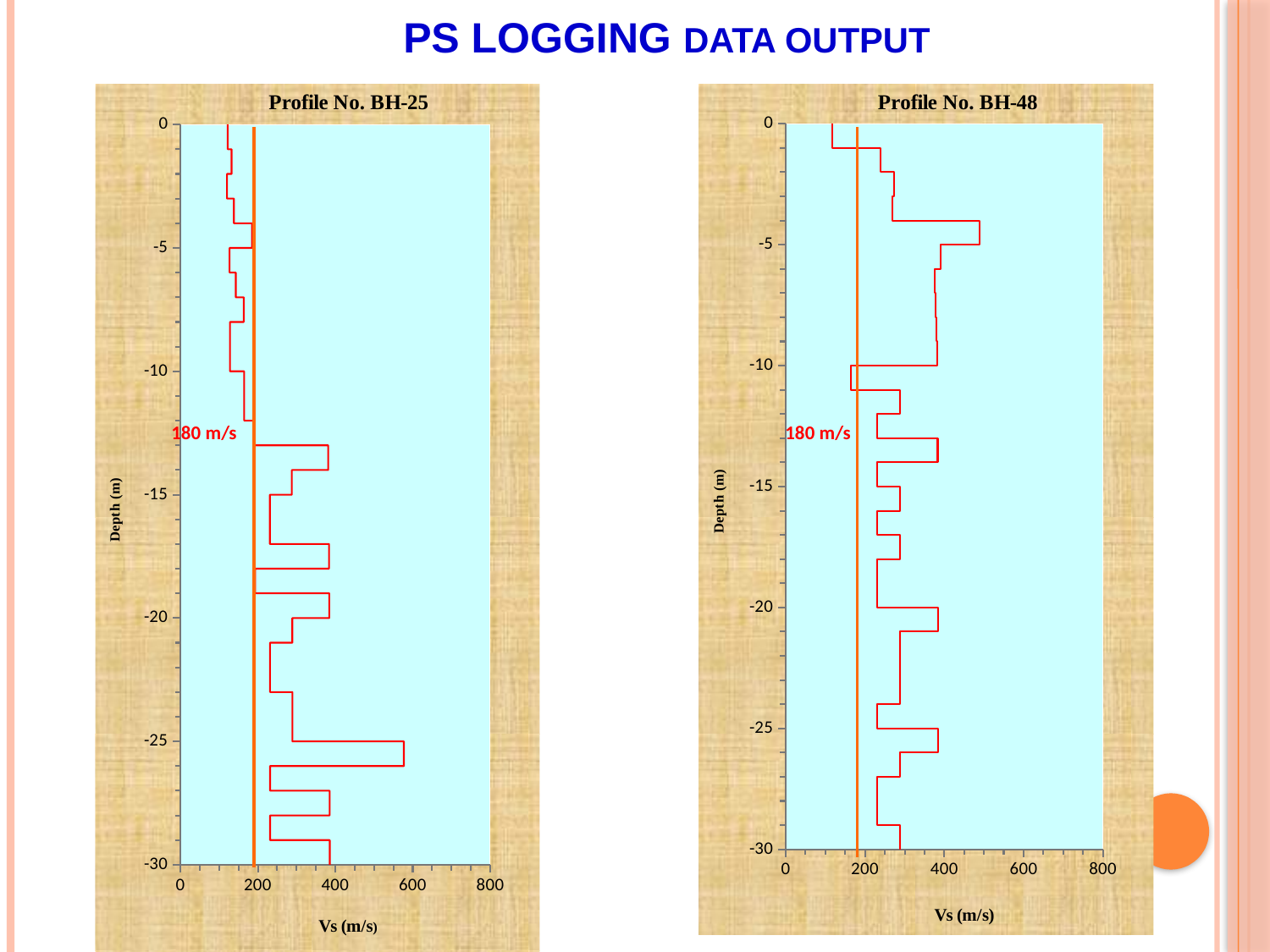
In the Profile No. BH-48 chart, is the Vs value between depths -10 and -11 m greater or less than 200? less In the Profile No. BH-48 chart, what is the maximum value shown on the Vs (m/s) axis? 800 In the Profile No. BH-48 chart, is the Vs value between depths 0 and -1 m greater or less than 200? less What is the title of the chart on the right side of the slide? Profile No. BH-48 In the Profile No. BH-48 chart, what value is marked by the vertical orange reference line? 180 m/s How many charts are shown on the slide? 2 In the Profile No. BH-48 chart, is the Vs value between depths -4 and -5 m greater or less than 400? greater In the Profile No. BH-25 chart, what is the label on the horizontal axis? Vs (m/s) In the Profile No. BH-25 chart, which depth interval has the highest Vs value, -25 to -26 m or -13 to -14 m? -25 to -26 m What kind of chart is the Profile No. BH-25 chart? line chart